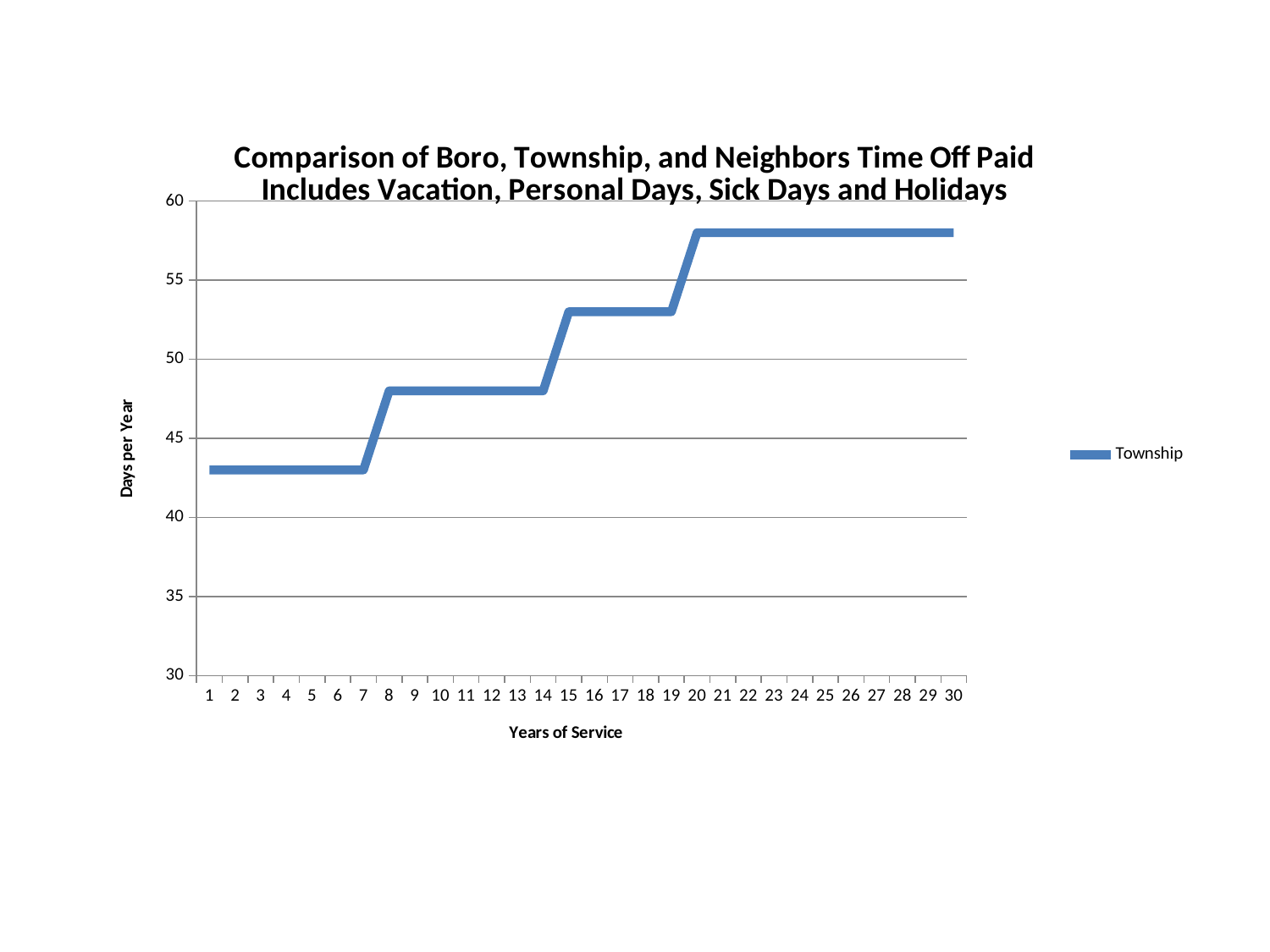
What kind of chart is shown on the slide? line chart Which is larger, the Township value at year 5 or at year 25? year 25 How many series does the legend list? 1 Do the Township values rise or fall as years of service increase? rise Is the Township value at year 25 greater or less than 55? greater Is the Township value at year 1 greater or less than 45? less Is the Township value at year 10 greater or less than 50? less What is the label of the y axis? Days per Year What is the name of the series shown in the legend? Township How many years of service are plotted along the x axis? 30